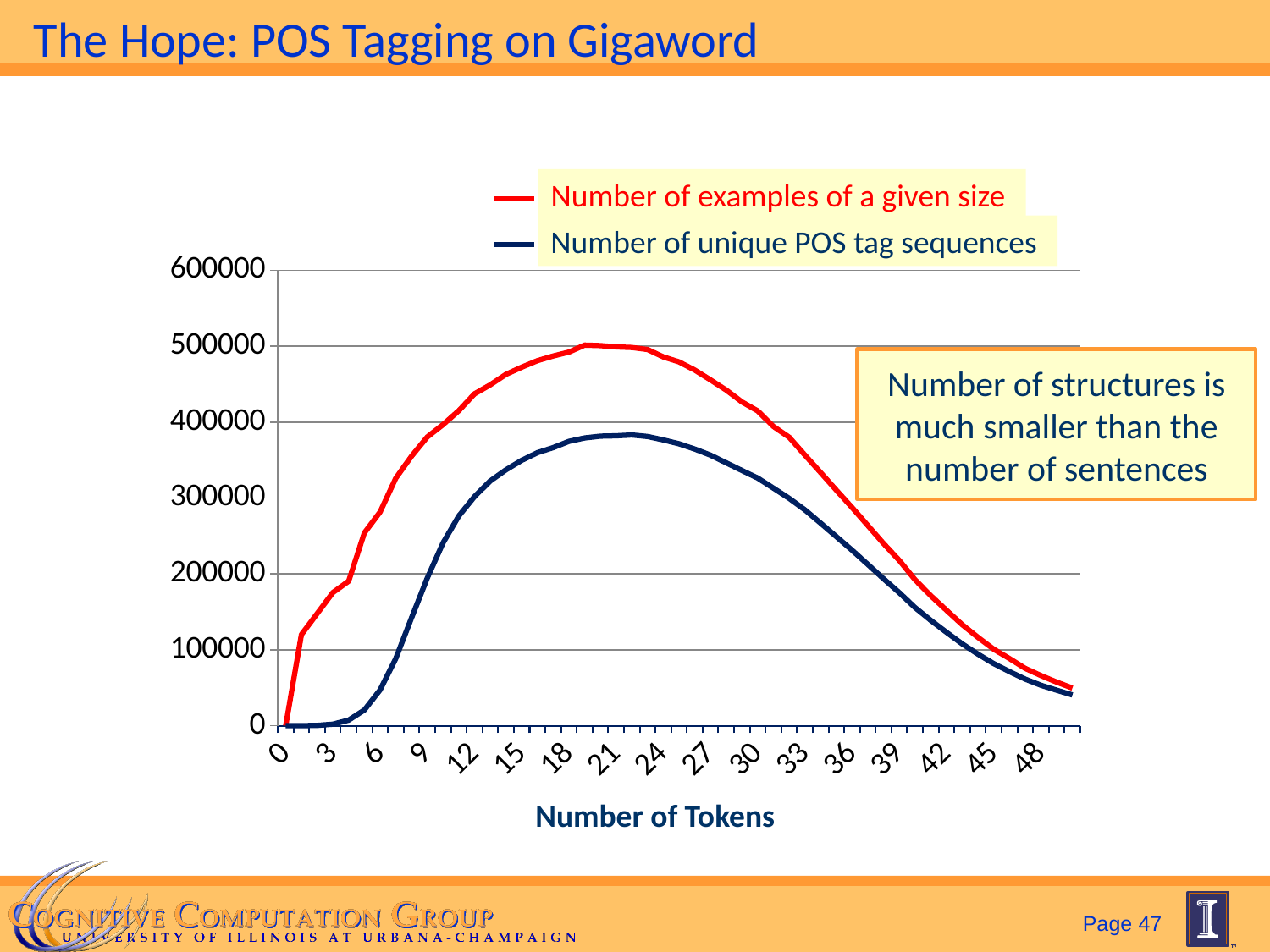
Does the 'Number of examples of a given size' series rise or fall between 24 and 48 tokens? fall Is the value of 'Number of unique POS tag sequences' at 39 tokens greater or less than 200000? less Is the value of 'Number of unique POS tag sequences' at 21 tokens greater or less than 400000? less Is the value of 'Number of examples of a given size' at 3 tokens greater or less than 100000? greater What is the title of the x axis? Number of Tokens Which series is drawn in red according to the legend? Number of examples of a given size Does the 'Number of unique POS tag sequences' series rise or fall between 6 and 18 tokens? rise What kind of chart is shown on the slide? line chart At 21 tokens, which series has the larger value: 'Number of examples of a given size' or 'Number of unique POS tag sequences'? Number of examples of a given size How many series does the legend list? 2